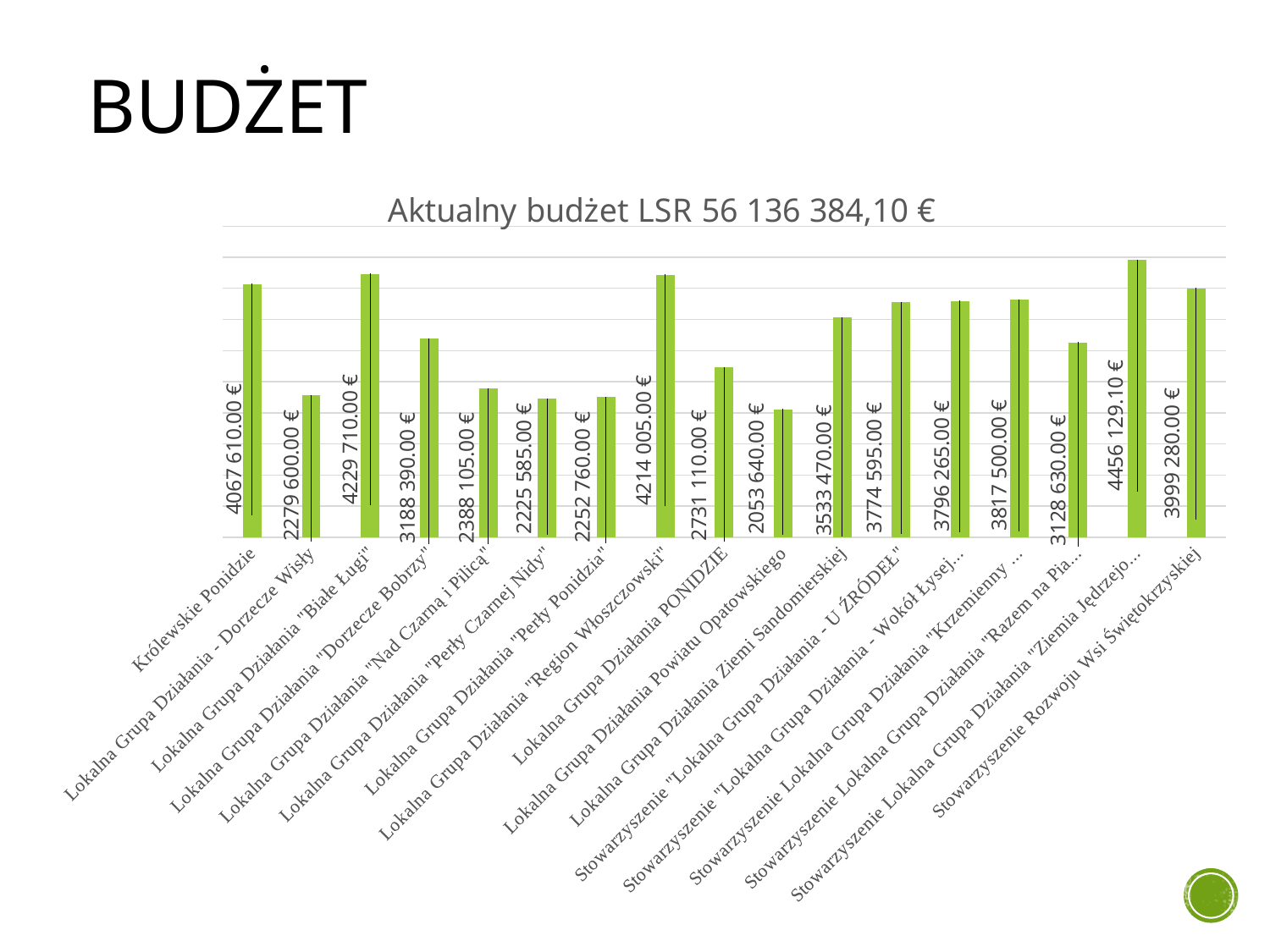
What is the value for Lokalna Grupa Działania "Białe Ługi"? 4229 710.00 € Which category has the highest value? Stowarzyszenie Lokalna Grupa Działania "Ziemia Jędrzejo..." Which category has the lowest value? Lokalna Grupa Działania Powiatu Opatowskiego What is the value for Stowarzyszenie Rozwoju Wsi Świętokrzyskiej? 3999 280.00 € How many categories are shown in the chart? 17 What is the difference between the values for Lokalna Grupa Działania "Białe Ługi" and Królewskie Ponidzie? 162 100.00 € What is the value for Królewskie Ponidzie? 4067 610.00 € What is the value for Lokalna Grupa Działania "Region Włoszczowski"? 4214 005.00 € What is the title of the chart? Aktualny budżet LSR 56 136 384,10 € What kind of chart is shown on the slide? Bar chart Which is larger, the value for Lokalna Grupa Działania Ziemi Sandomierskiej or Lokalna Grupa Działania PONIDZIE? Lokalna Grupa Działania Ziemi Sandomierskiej What is the value for Lokalna Grupa Działania Powiatu Opatowskiego? 2053 640.00 €